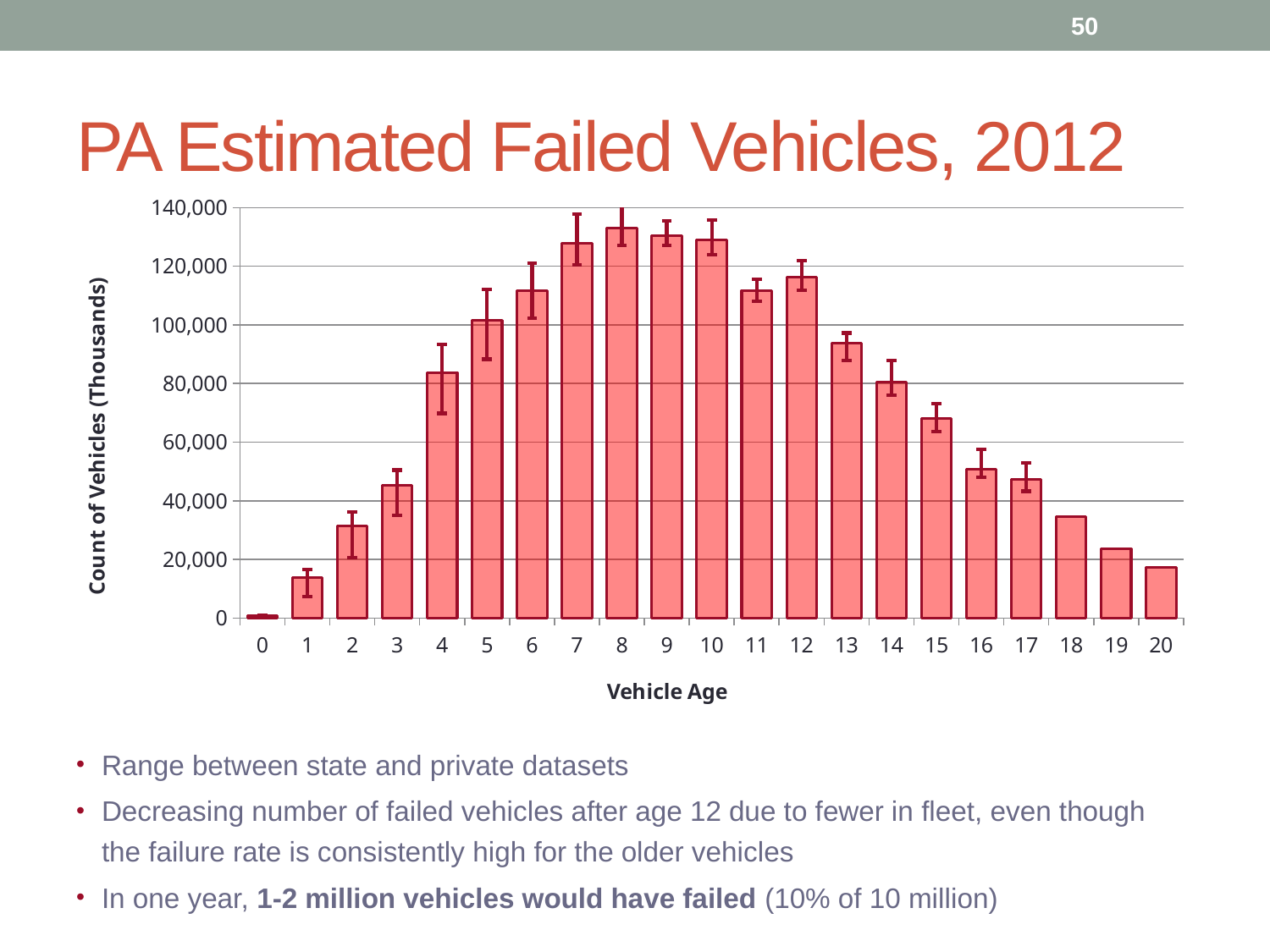
Which has a higher count of failed vehicles, vehicle age 12 or vehicle age 14? 12 What is the label of the y axis? Count of Vehicles (Thousands) Which has a higher count of failed vehicles, vehicle age 3 or vehicle age 15? 15 Which vehicle age has the highest count of failed vehicles? 8 Is the count of vehicles for vehicle age 13 greater or less than 100,000? less Do the counts of failed vehicles rise or fall from vehicle age 12 to vehicle age 20? fall How many vehicle age categories are plotted on the x axis? 21 Which vehicle age has the lowest count of failed vehicles? 0 Is the count of vehicles for vehicle age 4 greater or less than 80,000? greater Is the count of vehicles for vehicle age 20 greater or less than 20,000? less What kind of chart is shown on the slide? bar chart